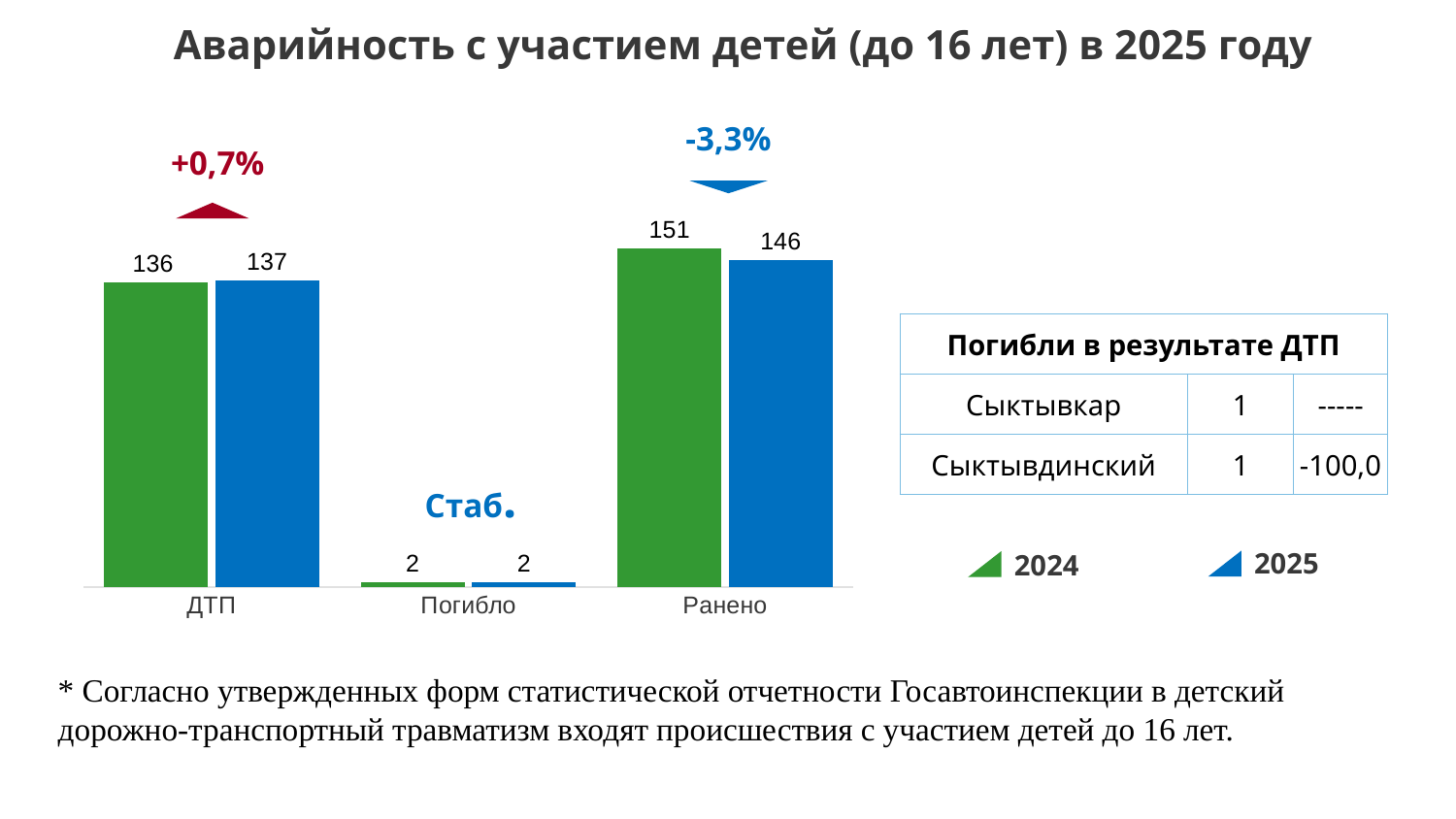
What kind of chart is shown on the slide? bar chart What is the difference between the 2024 and 2025 values for Ранено? 5 Which category has the highest value in the 2024 series? Ранено What is the value for Ранено in 2025? 146 How many categories are shown on the x axis? 3 What is the value for Ранено in 2024? 151 How many series does the legend list? 2 What is the value for Погибло in 2025? 2 What is the value for ДТП in 2025? 137 What is the value for ДТП in 2024? 136 Which is larger, the 2024 value for ДТП or the 2025 value for ДТП? 2025 Which category has the lowest value in the 2025 series? Погибло